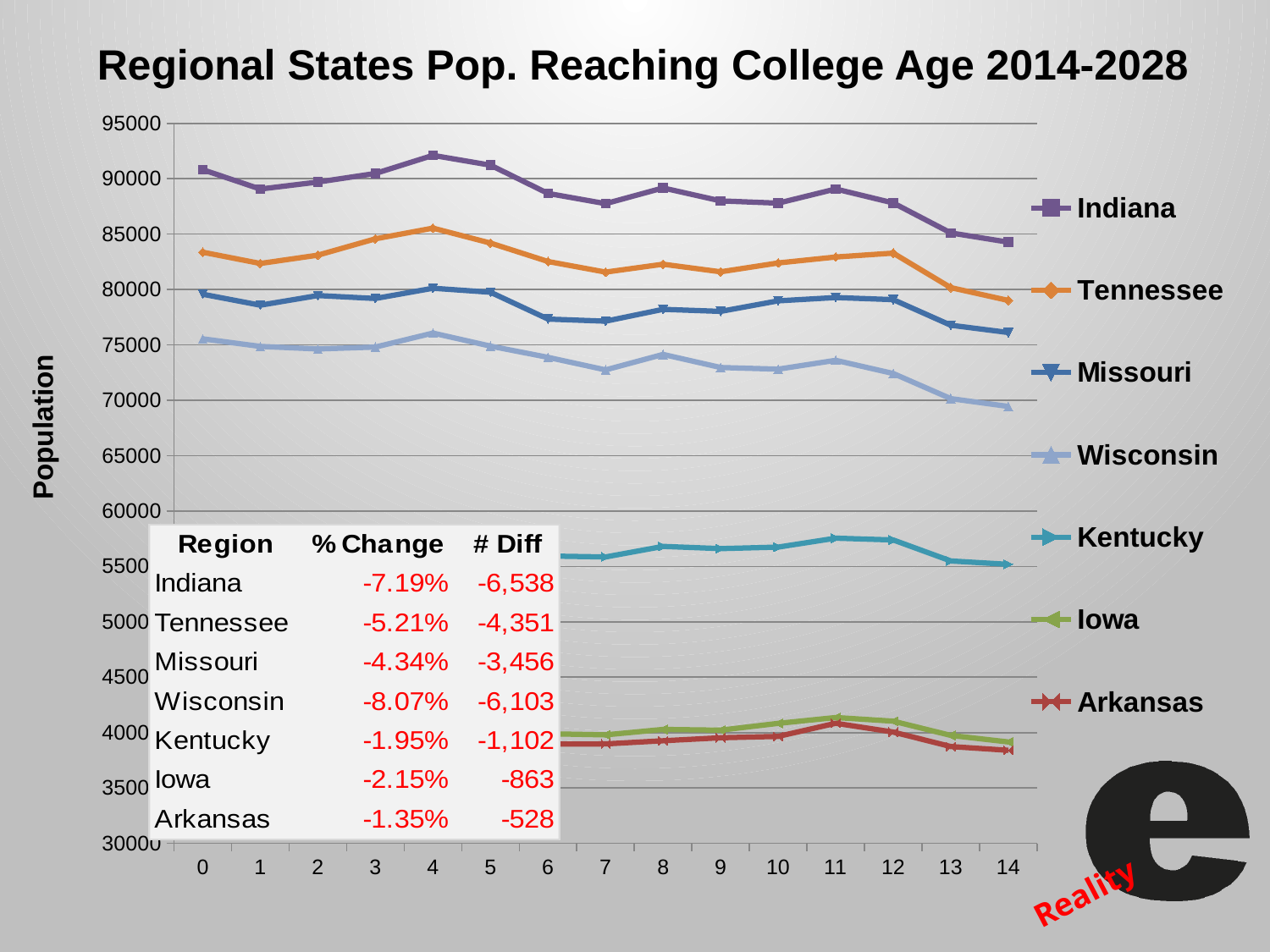
Which state has the highest population values across the chart? Indiana Is the value for Indiana at x = 14 greater or less than 85000? less How many series does the legend list? 7 What is the title of the chart? Regional States Pop. Reaching College Age 2014-2028 What kind of chart is shown on the slide? line chart Is the value for Kentucky at x = 11 greater or less than 55000? greater Is the value for Wisconsin at x = 14 greater or less than 70000? less How many points are plotted along the x axis for each series? 15 Which state has the lowest population values across the chart? Arkansas At x = 4, which is larger, the value for Tennessee or the value for Missouri? Tennessee Does the Indiana line rise or fall overall from x = 0 to x = 14? fall